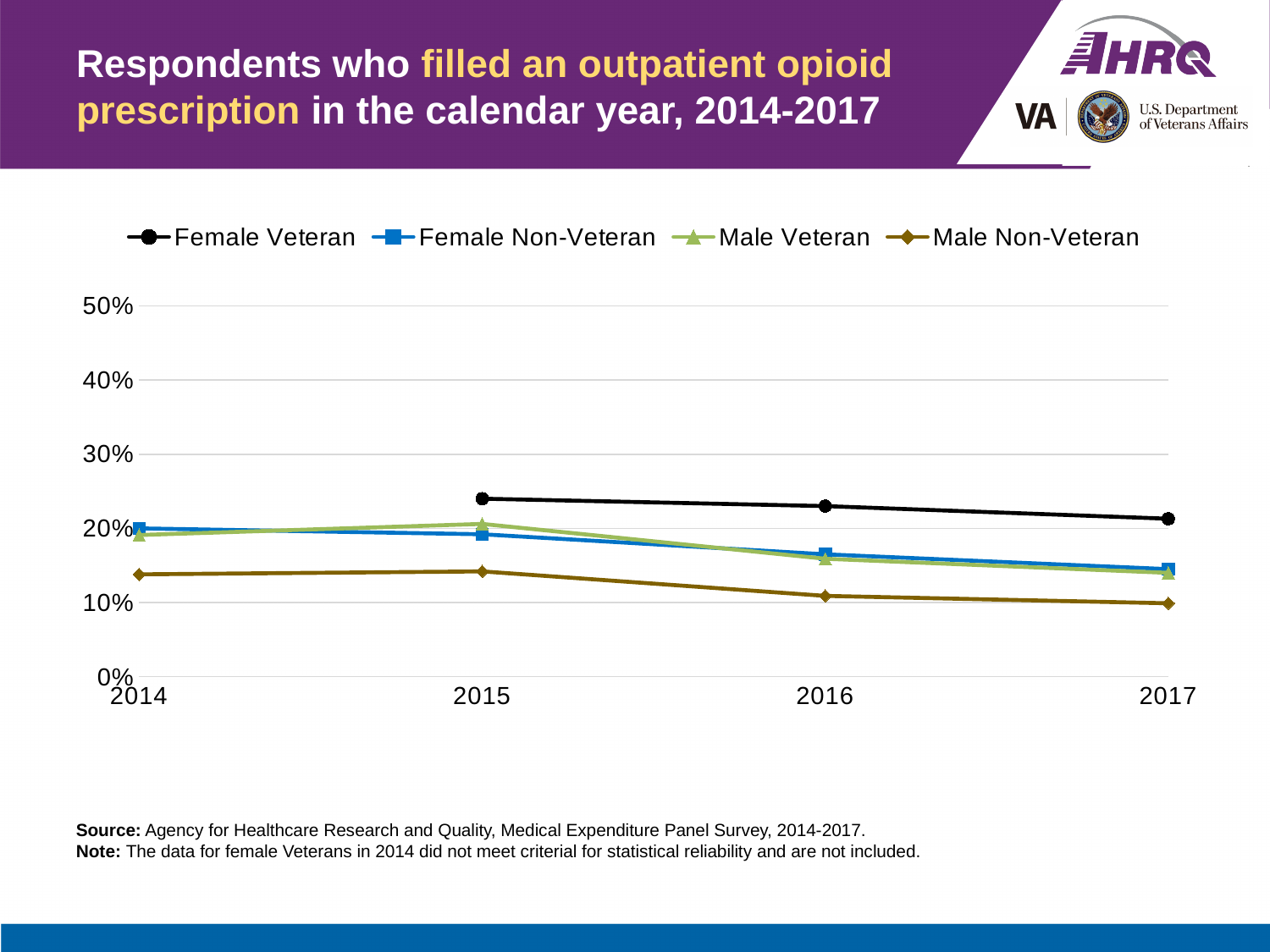
Which series has the lowest value in 2016? Male Non-Veteran In 2017, which is larger: the value for Female Veteran or the value for Male Non-Veteran? Female Veteran What kind of chart is shown on the slide? line chart Which series has no data point plotted for 2014? Female Veteran Is the value for Female Non-Veteran in 2017 greater or less than 20%? less Which series has the highest value in 2016? Female Veteran Is the value for Male Non-Veteran in 2014 greater or less than 10%? greater How many series does the legend list? 4 How many years are shown on the x axis? 4 Is the value for Female Veteran in 2015 greater or less than 20%? greater Does the Male Non-Veteran line rise or fall from 2015 to 2017? fall